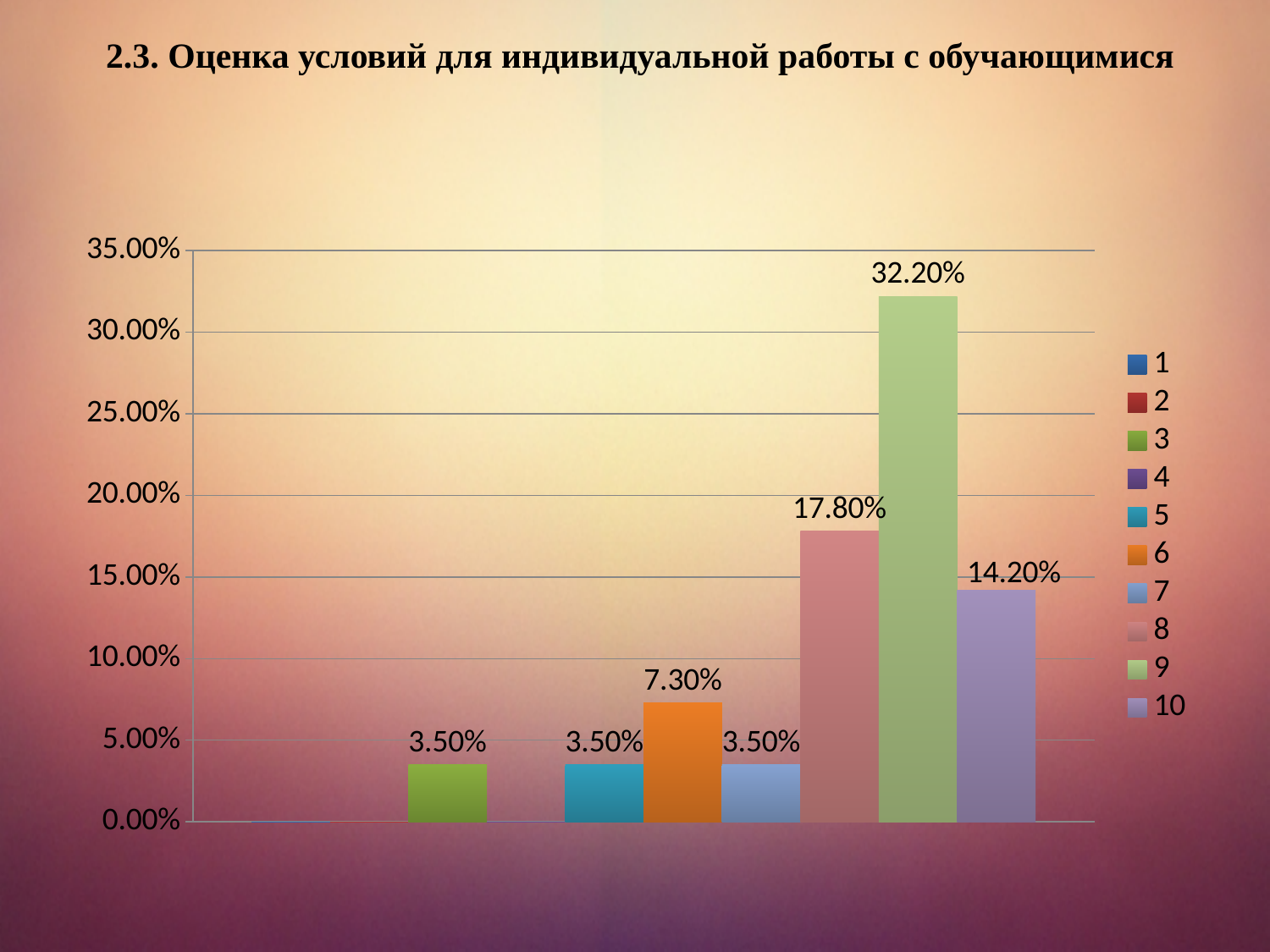
What value is shown for series 6? 7.30% How many entries does the legend list? 10 What kind of chart is shown on the slide? bar chart Is the value for series 9 greater or less than 30.00%? greater What is the title of the slide? 2.3. Оценка условий для индивидуальной работы с обучающимися What is the difference between the values for series 10 and series 6? 6.90% What value is shown for series 9? 32.20% Which series has the highest value? 9 What value is shown for series 10? 14.20% Which is larger, the value for series 8 or the value for series 10? 8 What value is shown for series 8? 17.80% What is the difference between the values for series 9 and series 8? 14.40%